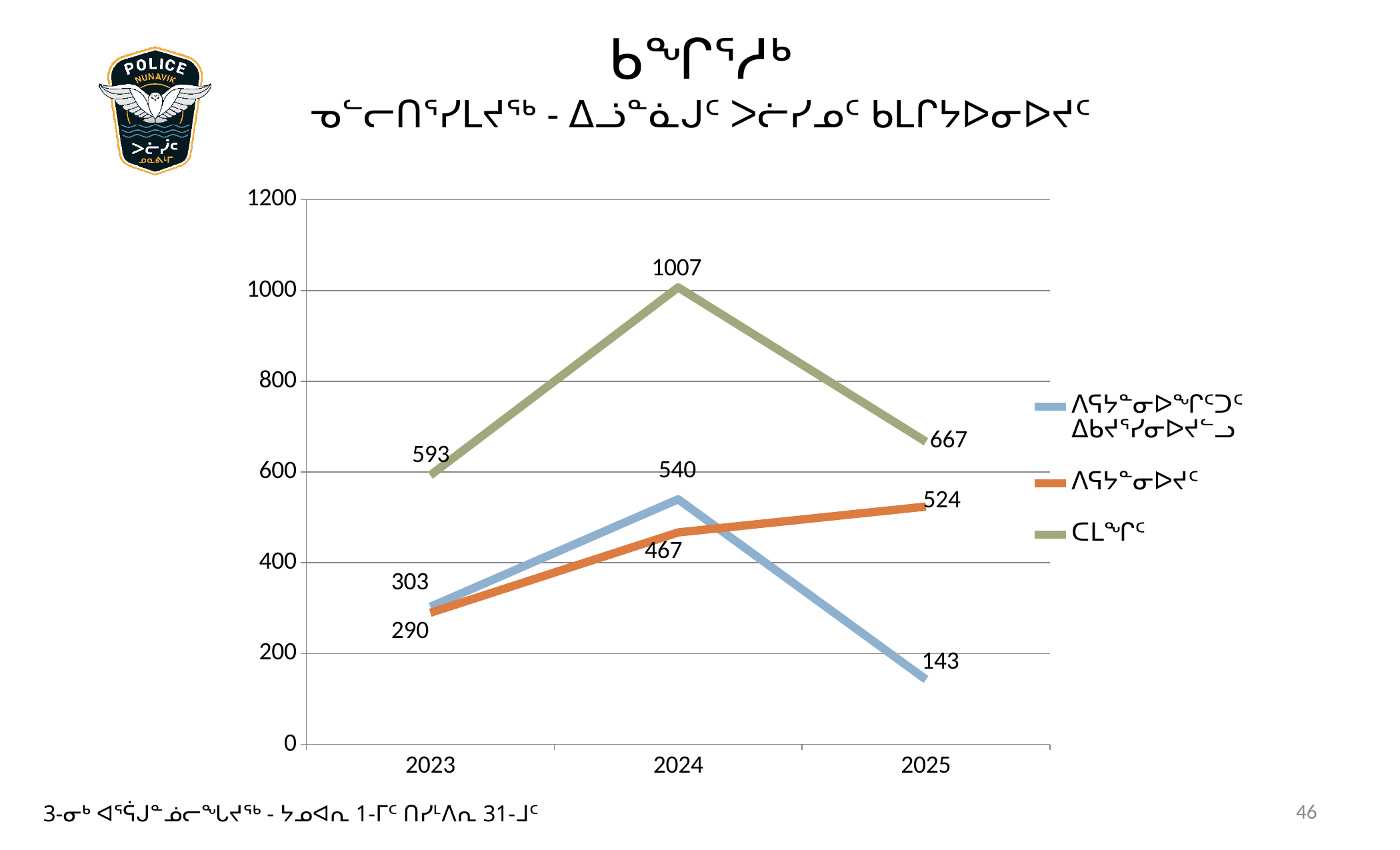
In which year does the blue line have its lowest value? 2025 How many series does the legend list? 3 What is the value of the orange line in 2023? 290 In 2025, which line has the larger value, the orange line or the blue line? orange line What is the value of the green line in 2024? 1007 What is the difference between the blue line's 2024 value and its 2025 value? 397 By how much did the green line increase from 2023 to 2024? 414 How many years are shown on the x axis? 3 What type of chart is shown on the slide? line chart In which year does the green line reach its highest value? 2024 What is the value of the blue line in 2025? 143 Does the orange line rise or fall from 2023 to 2025? rise